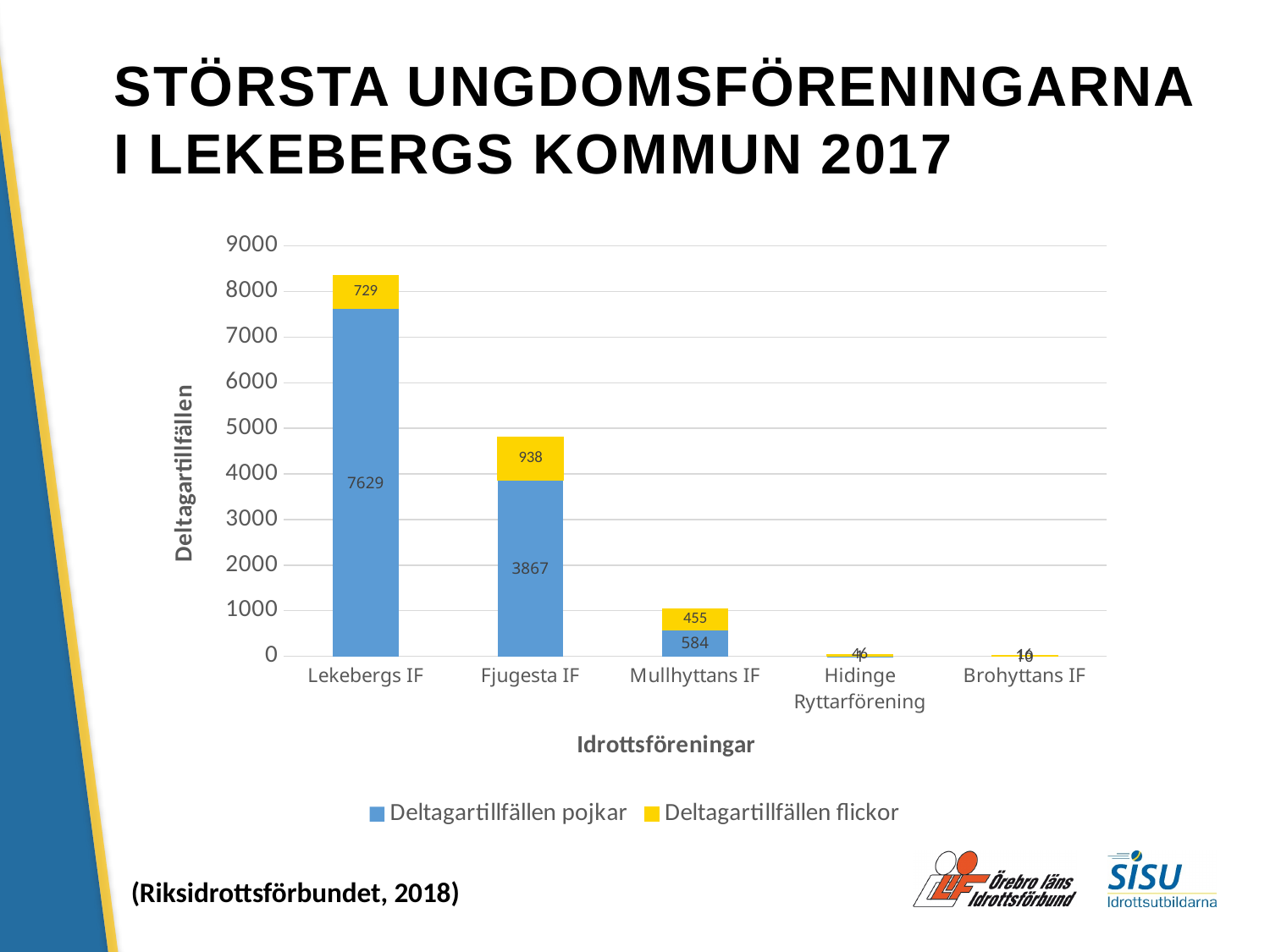
Which colour represents Deltagartillfällen flickor in the chart? Yellow What type of chart is shown on the slide? Stacked bar chart What is the value of Deltagartillfällen flickor for Fjugesta IF? 938 What is the total of the stacked bar for Fjugesta IF? 4805 What is the value of Deltagartillfällen pojkar for Mullhyttans IF? 584 What is the difference between Deltagartillfällen pojkar for Lekebergs IF and Fjugesta IF? 3762 What is the value of Deltagartillfällen pojkar for Lekebergs IF? 7629 Which club has the highest value for Deltagartillfällen flickor? Fjugesta IF Which club has the highest value for Deltagartillfällen pojkar? Lekebergs IF Is the total stacked bar for Lekebergs IF greater or less than 8000? greater How many series does the legend list? 2 How many sports clubs (categories) are shown on the x axis? 5